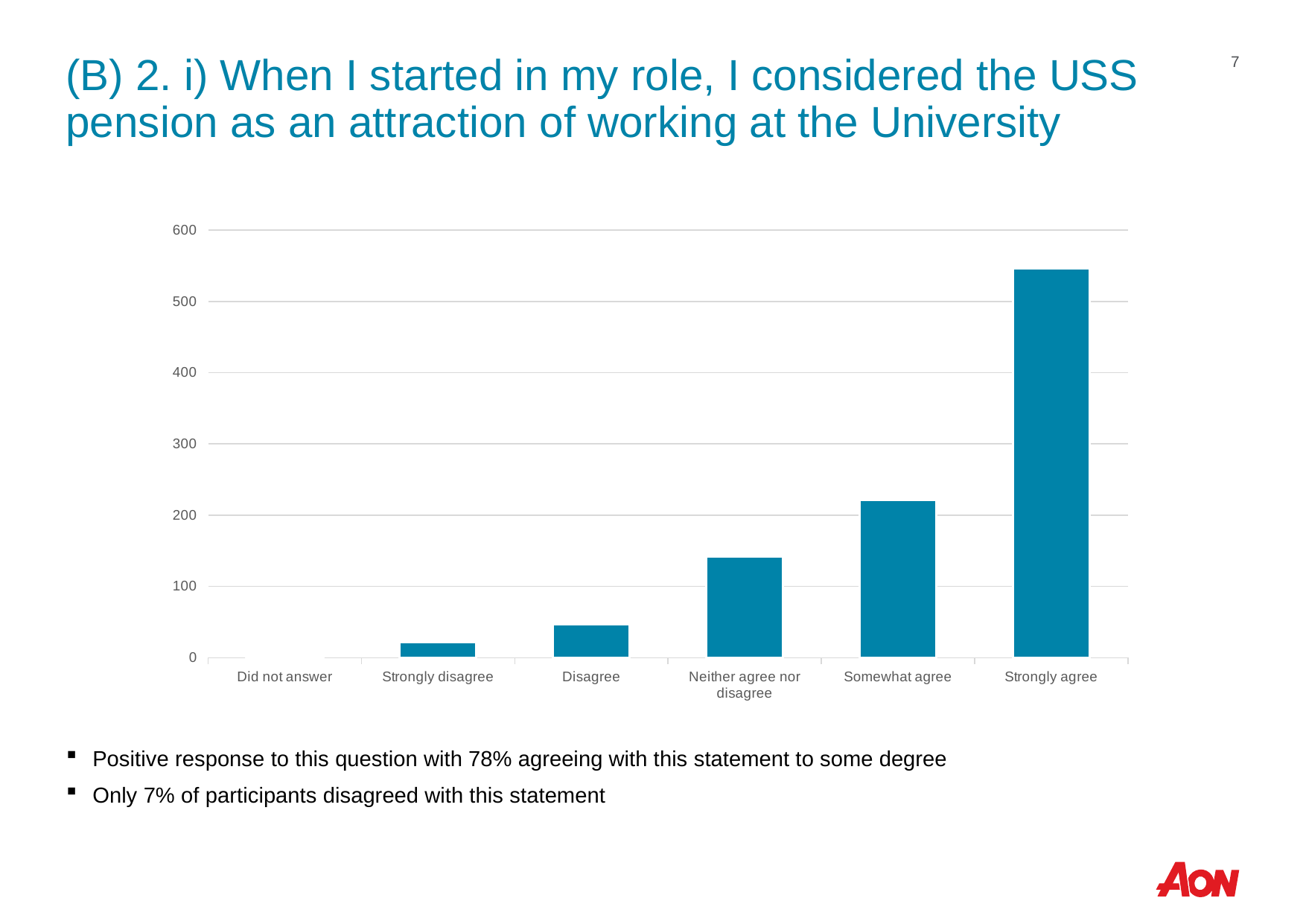
How many response categories are shown on the x axis of the chart? 6 Is the value for Neither agree nor disagree greater or less than 200? less Which response category has the highest bar? Strongly agree Is the value for Strongly agree greater or less than 500? greater Which is larger, the value for Disagree or the value for Strongly disagree? Disagree What kind of chart is shown on the slide? bar chart Is the value for Somewhat agree greater or less than 200? greater Which is larger, the value for Somewhat agree or the value for Neither agree nor disagree? Somewhat agree What is the highest value shown on the y axis of the chart? 600 Do the bar values generally rise or fall moving from left to right along the x axis? rise